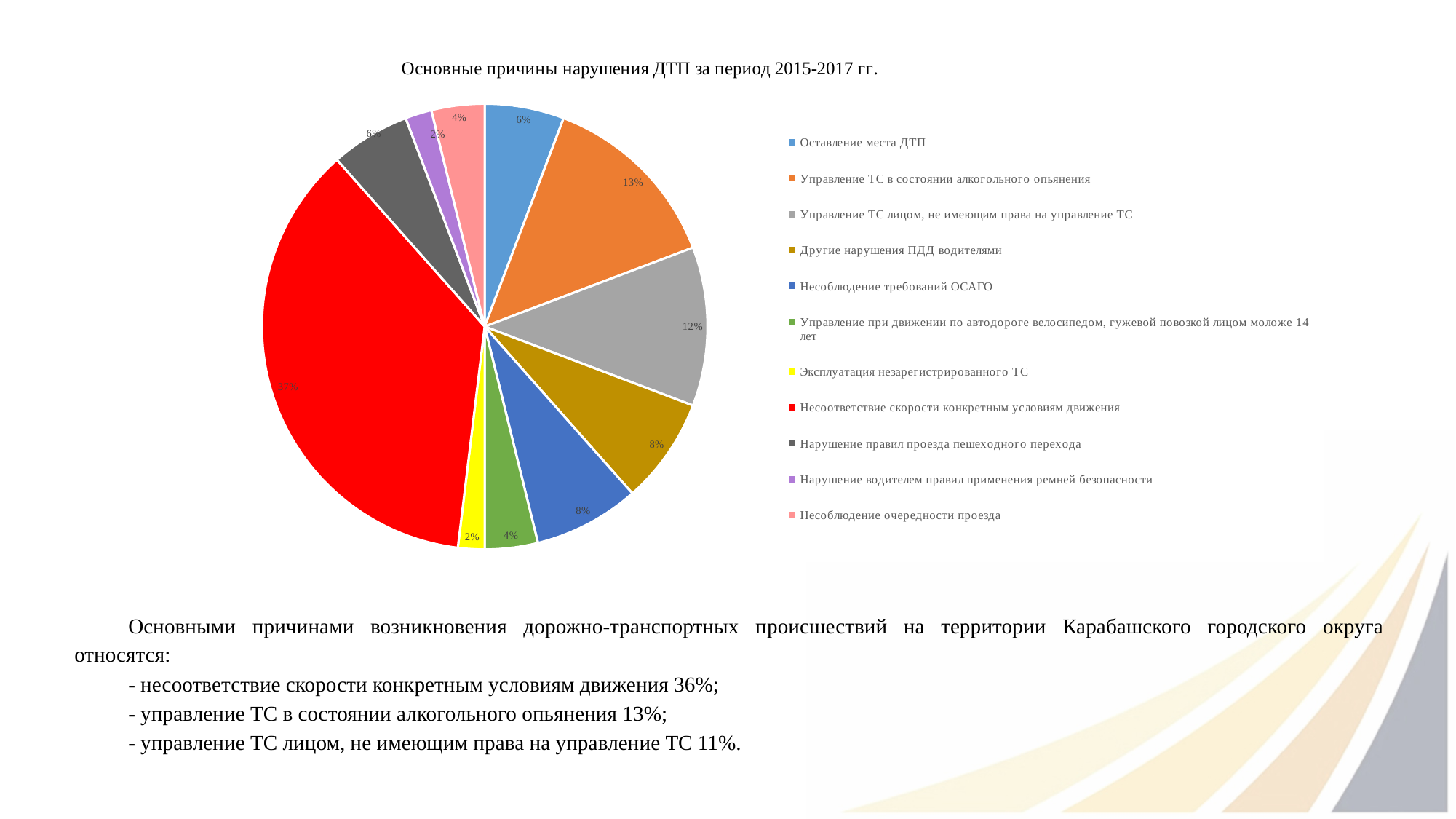
Which category has the largest slice of the pie? Несоответствие скорости конкретным условиям движения What share of the pie is labelled for 'Управление ТС в состоянии алкогольного опьянения'? 13% By how many percentage points does the share for 'Управление ТС в состоянии алкогольного опьянения' exceed the share for 'Оставление места ДТП'? 7% What share of the pie is labelled for 'Эксплуатация незарегистрированного ТС'? 2% What share of the pie is labelled for 'Оставление места ДТП'? 6% What is the title of the chart? Основные причины нарушения ДТП за период 2015-2017 гг. How many categories does the legend of the pie chart list? 11 What share of the pie is labelled for 'Управление ТС лицом, не имеющим права на управление ТС'? 12% What share of the pie is labelled for 'Другие нарушения ПДД водителями'? 8% Which slice is larger: 'Несоблюдение требований ОСАГО' or 'Управление при движении по автодороге велосипедом, гужевой повозкой лицом моложе 14 лет'? Несоблюдение требований ОСАГО What share of the pie is labelled for 'Несоблюдение очередности проезда'? 4% What kind of chart is shown on the slide? pie chart